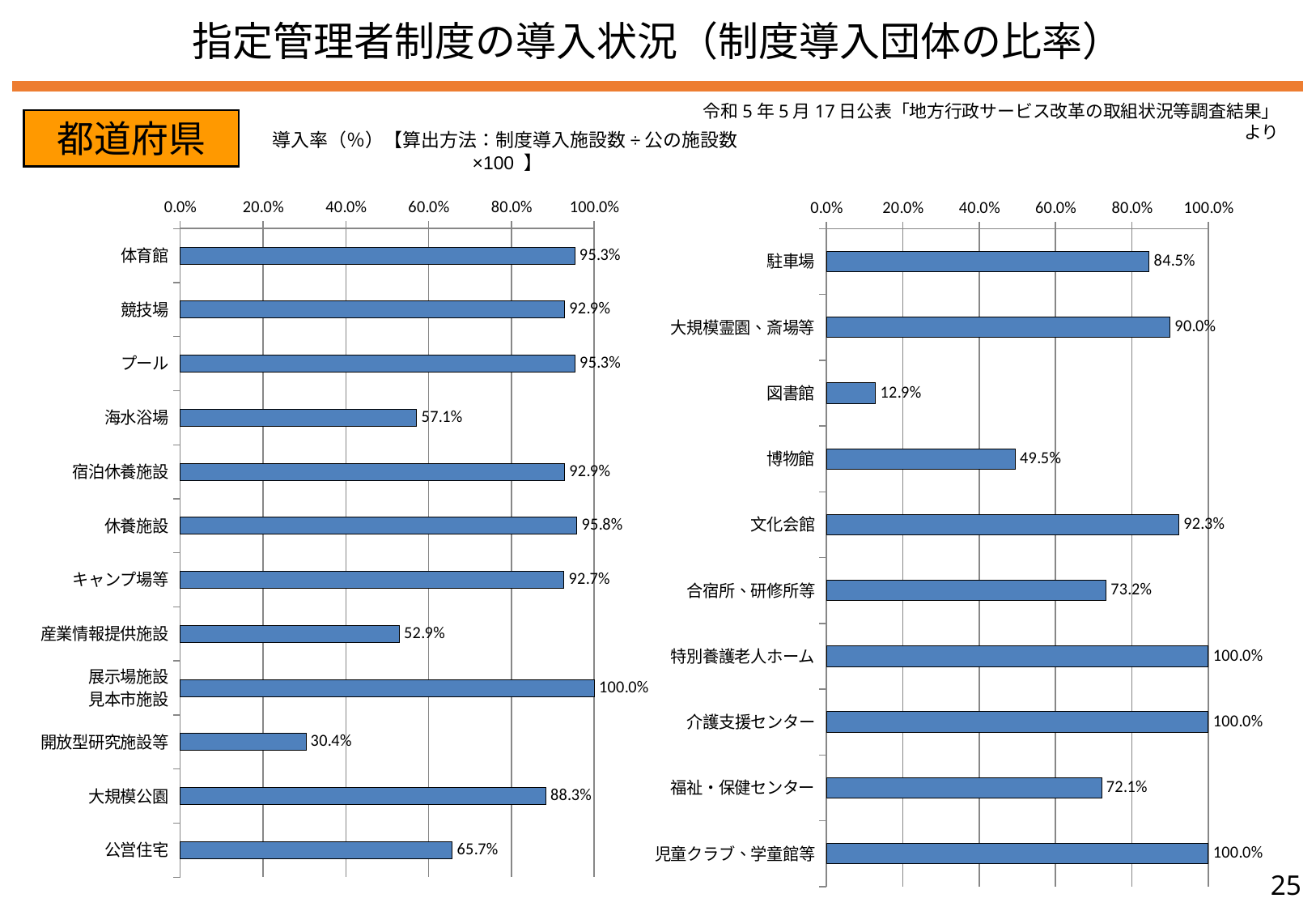
What kind of chart is the left chart? Bar chart In the left chart, which category has the highest value? 展示場施設見本市施設 In the left chart, how many categories are shown? 12 In the right chart, which category has the lowest value? 図書館 In the left chart, what is the value for 海水浴場? 57.1% In the right chart, what is the difference between the values for 駐車場 and 図書館? 71.6% In the right chart, what is the value for 博物館? 49.5% In the right chart, how many categories have a value of 100.0%? 3 In the right chart, how many categories are shown? 10 In the right chart, which is larger, the value for 合宿所、研修所等 or 福祉・保健センター? 合宿所、研修所等 In the left chart, which category has the lowest value? 開放型研究施設等 In the left chart, what is the difference between the values for 大規模公園 and 公営住宅? 22.6%